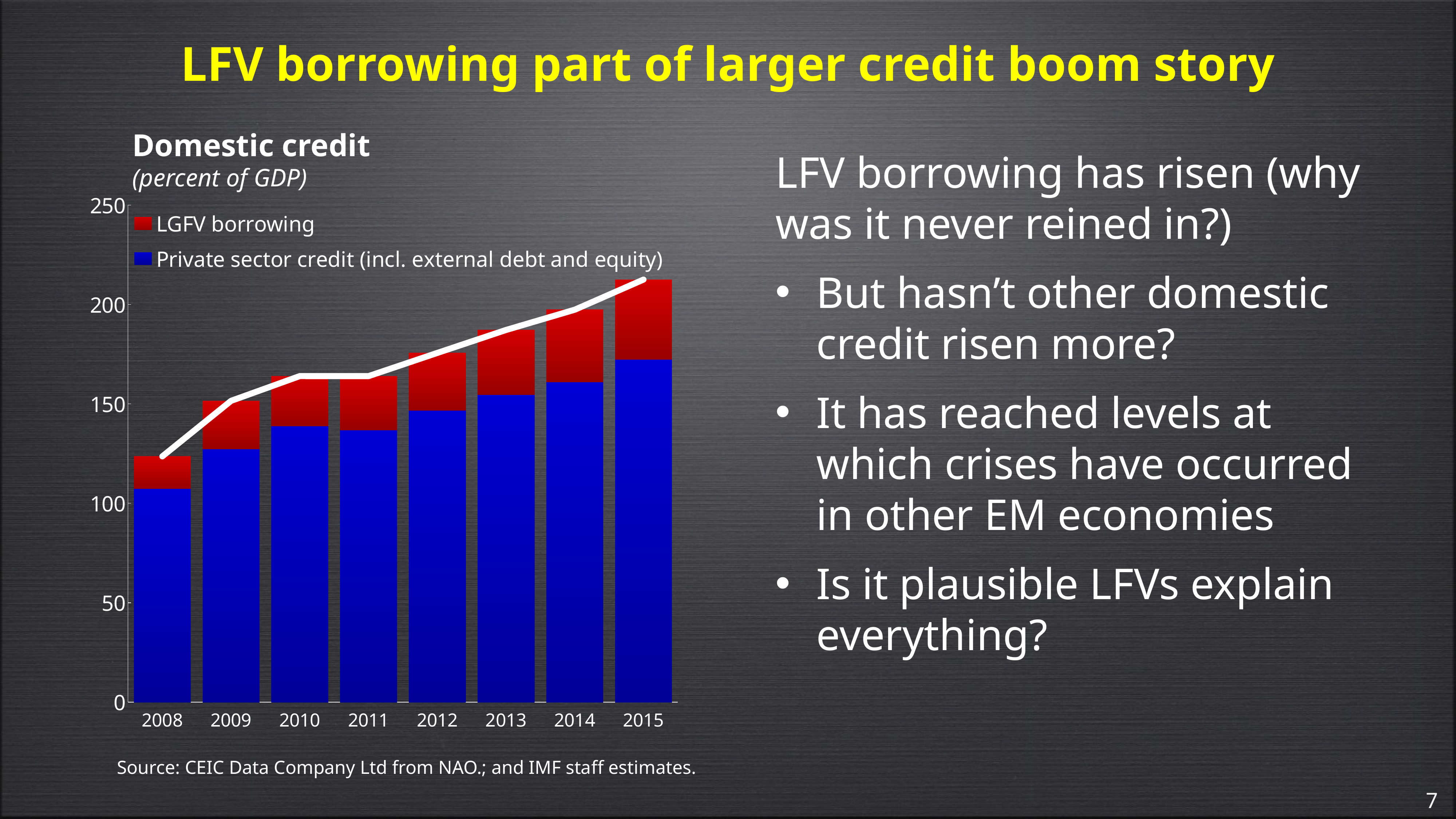
Which year has the lowest total domestic credit in the chart? 2008 How many years are shown on the x axis of the Domestic credit chart? 8 Which year has the larger LGFV borrowing segment, 2008 or 2015? 2015 Is the total domestic credit for 2015 greater or less than 200? greater Do the total domestic credit bars rise or fall from 2008 to 2015? Rise In what units is the Domestic credit chart measured, according to its subtitle? percent of GDP Is the Private sector credit value for 2015 greater or less than 150? greater Is the Private sector credit value for 2010 greater or less than 150? less How many series does the legend of the Domestic credit chart list? 2 What kind of chart is shown on the slide? Stacked bar chart with a line overlay Which year has the highest total domestic credit in the chart? 2015